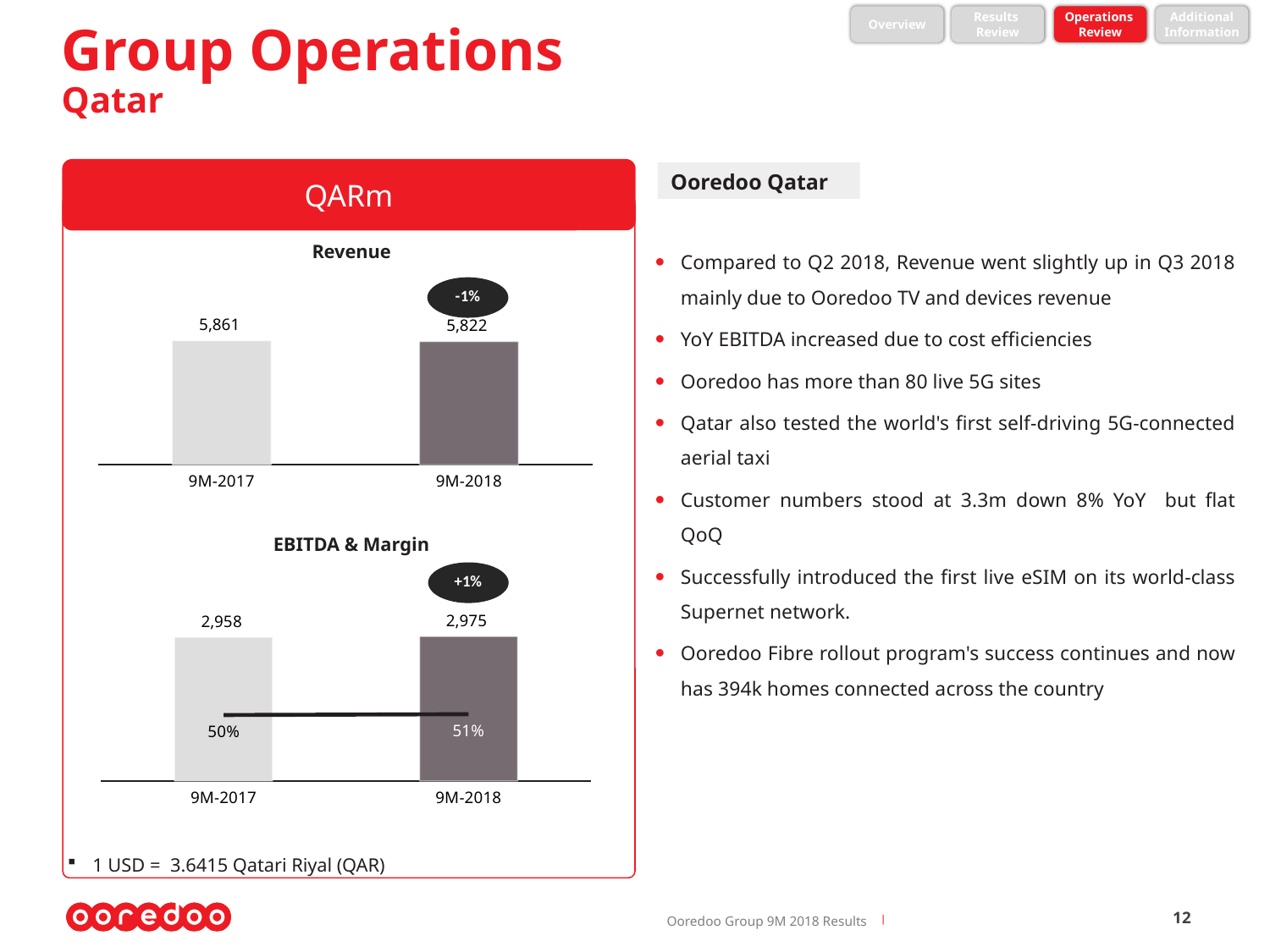
In the EBITDA & Margin chart, what is the margin for 9M-2017? 50% In the EBITDA & Margin chart, what is the difference between the 9M-2018 and 9M-2017 EBITDA values? 17 In the Revenue chart, what is the value for 9M-2017? 5,861 In the Revenue chart, what is the value for 9M-2018? 5,822 How many periods are shown on the x axis of the Revenue chart? 2 What type of chart is the Revenue chart? Bar chart In the Revenue chart, what percentage change is shown in the bubble above the 9M-2018 bar? -1% In the EBITDA & Margin chart, what is the EBITDA value for 9M-2017? 2,958 In the Revenue chart, what is the difference between the 9M-2017 and 9M-2018 values? 39 In the EBITDA & Margin chart, what percentage change is shown in the bubble above the 9M-2018 bar? +1% In the EBITDA & Margin chart, what is the margin for 9M-2018? 51% In the EBITDA & Margin chart, what is the EBITDA value for 9M-2018? 2,975